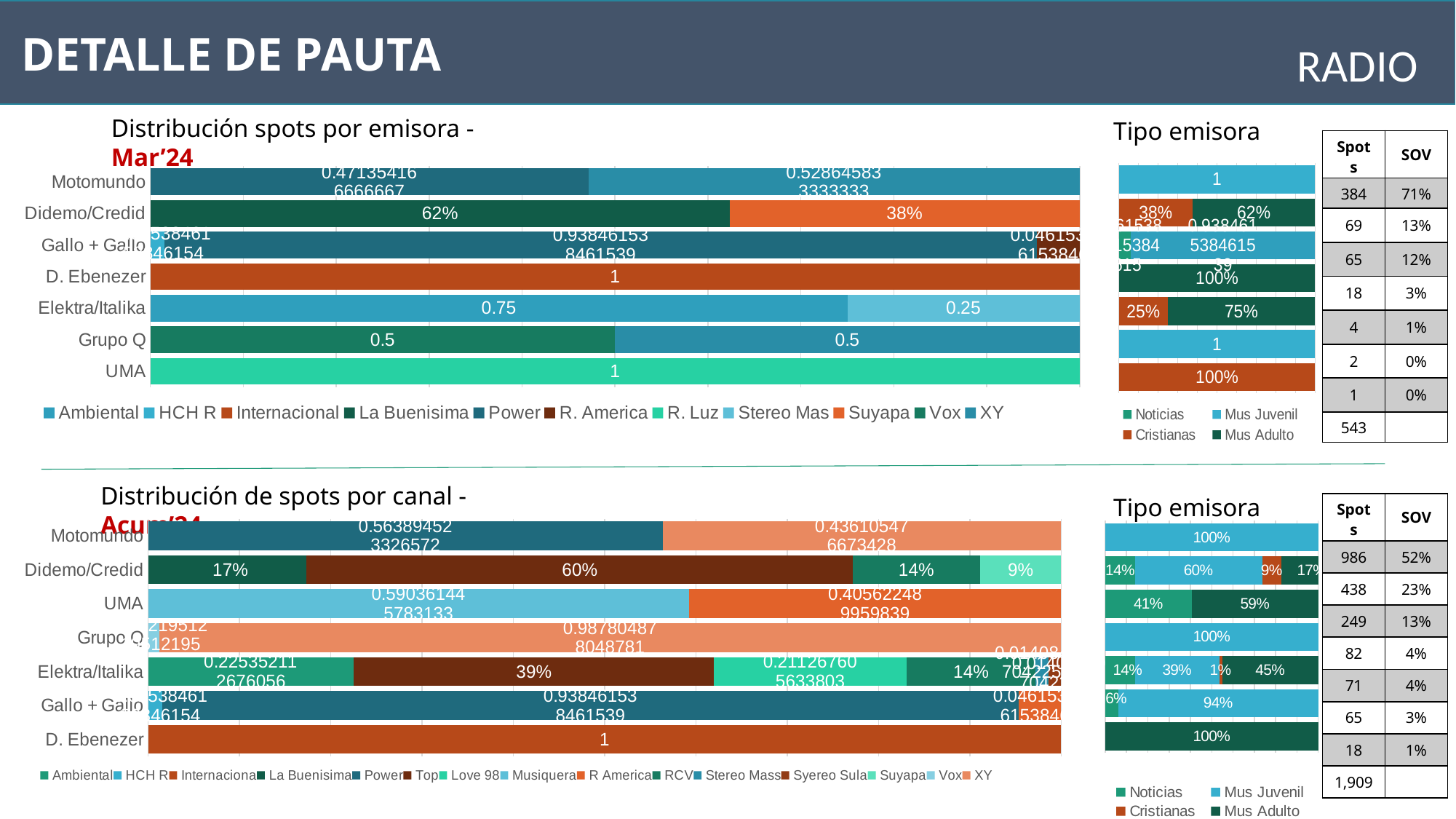
In the top 'Tipo emisora' chart, what is the value of the larger segment of the Elektra/Italika bar? 75% In the 'Distribución spots por emisora - Mar'24' chart, how many emisoras (categories) are shown on the vertical axis? 7 In the bottom 'Tipo emisora' chart, which is larger for Gallo + Gallo: the 6% segment or the 94% segment? 94% In the 'Distribución spots por emisora - Mar'24' chart, how many series does the legend list? 11 In the 'Distribución spots por emisora - Mar'24' chart, what is the value of the larger segment of the Didemo/Credid bar? 62% In the bottom 'Tipo emisora' chart, what is the value of the larger segment of the UMA bar? 59% In the 'Distribución de spots por canal - Acum'24' chart, what is the value of the largest segment of the Didemo/Credid bar? 60% In the 'Distribución spots por emisora - Mar'24' chart, what is the difference between the two segments of the Didemo/Credid bar? 24% What kind of chart is 'Distribución spots por emisora - Mar'24'? Stacked bar chart In the top 'Tipo emisora' chart, how many series does the legend list? 4 In the top 'Tipo emisora' chart, what is the difference between the two segments of the Didemo/Credid bar? 24% In the 'Distribución spots por emisora - Mar'24' chart, what is the value of the smaller segment of the Elektra/Italika bar? 0.25